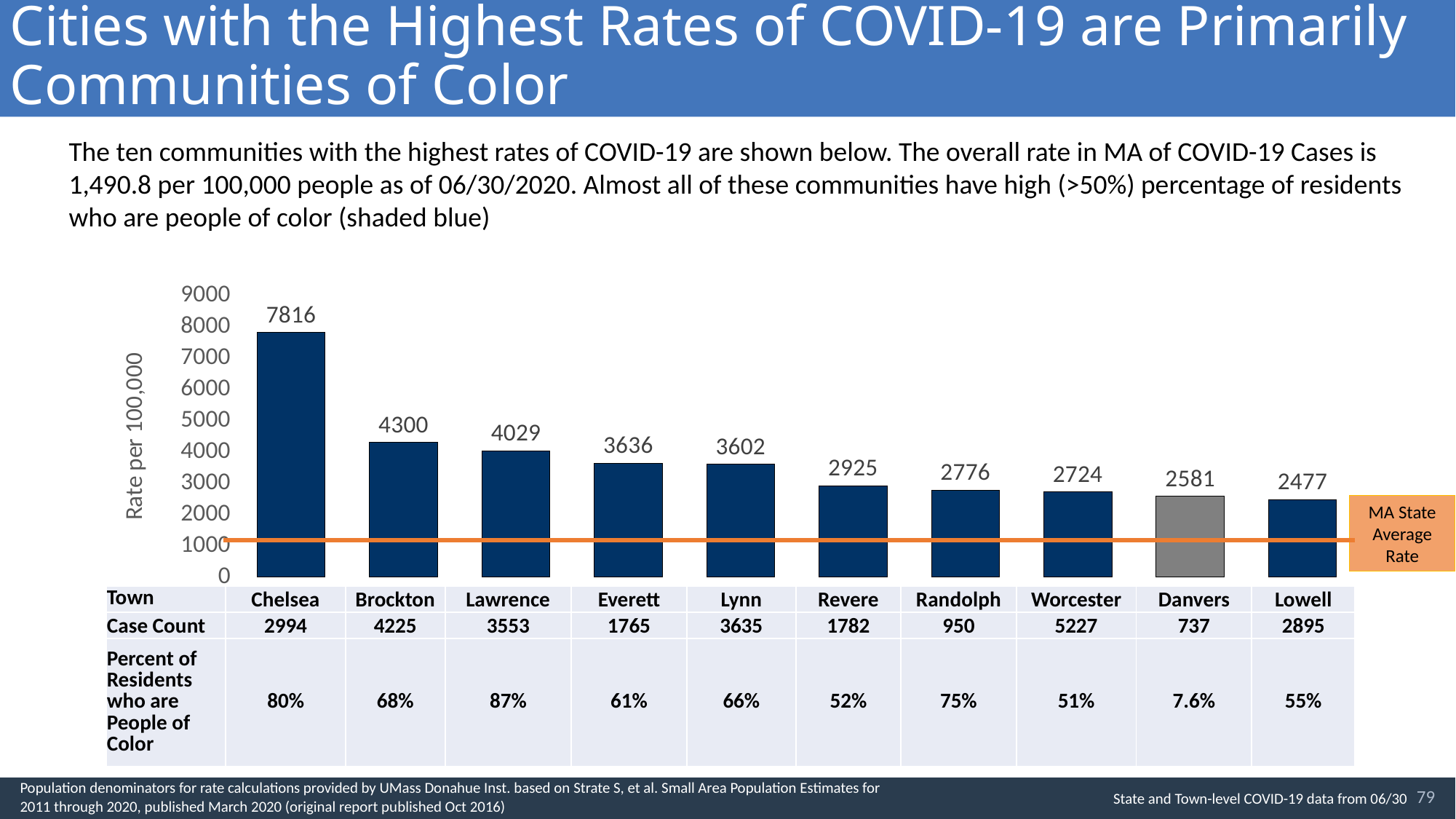
Which town's bar is shaded grey instead of blue? Danvers What is the rate per 100,000 for Chelsea? 7816 What is the difference between the rates for Chelsea and Brockton? 3516 Which town has the lowest rate per 100,000 among those shown? Lowell Do the rates rise or fall from left to right across the towns? fall Which has a higher rate per 100,000, Lawrence or Everett? Lawrence Which town has the highest rate per 100,000? Chelsea What does the orange horizontal line on the chart represent? MA State Average Rate What kind of chart is shown on the slide? bar chart Is the rate for Revere greater or less than 2000? greater How many towns are shown in the bar chart? 10 What is the rate per 100,000 for Worcester? 2724